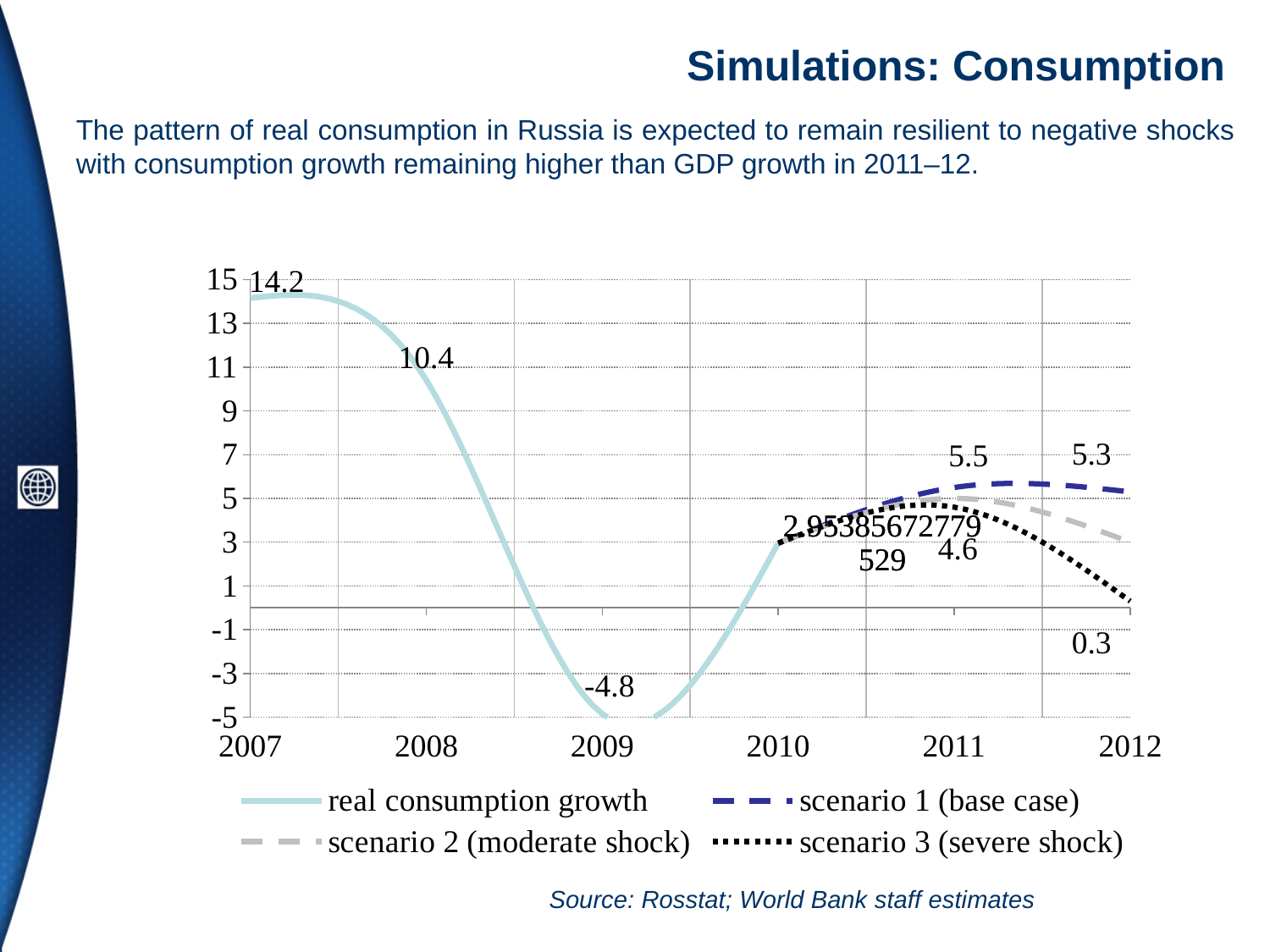
What is the value of real consumption growth in 2009? -4.8 Does real consumption growth rise or fall from 2007 to 2009? fall What is the value for scenario 1 (base case) in 2012? 5.3 Which is higher in 2012: scenario 1 (base case) or scenario 3 (severe shock)? scenario 1 (base case) What is the value of real consumption growth in 2008? 10.4 What is the value for scenario 1 (base case) in 2011? 5.5 What kind of chart is shown on the slide? line chart Is the value for scenario 2 (moderate shock) in 2012 greater or less than 5? less By how much did real consumption growth fall from 2007 to 2008? 3.8 What is the value for scenario 3 (severe shock) in 2012? 0.3 How many series does the legend list? 4 What is the value of real consumption growth in 2007? 14.2